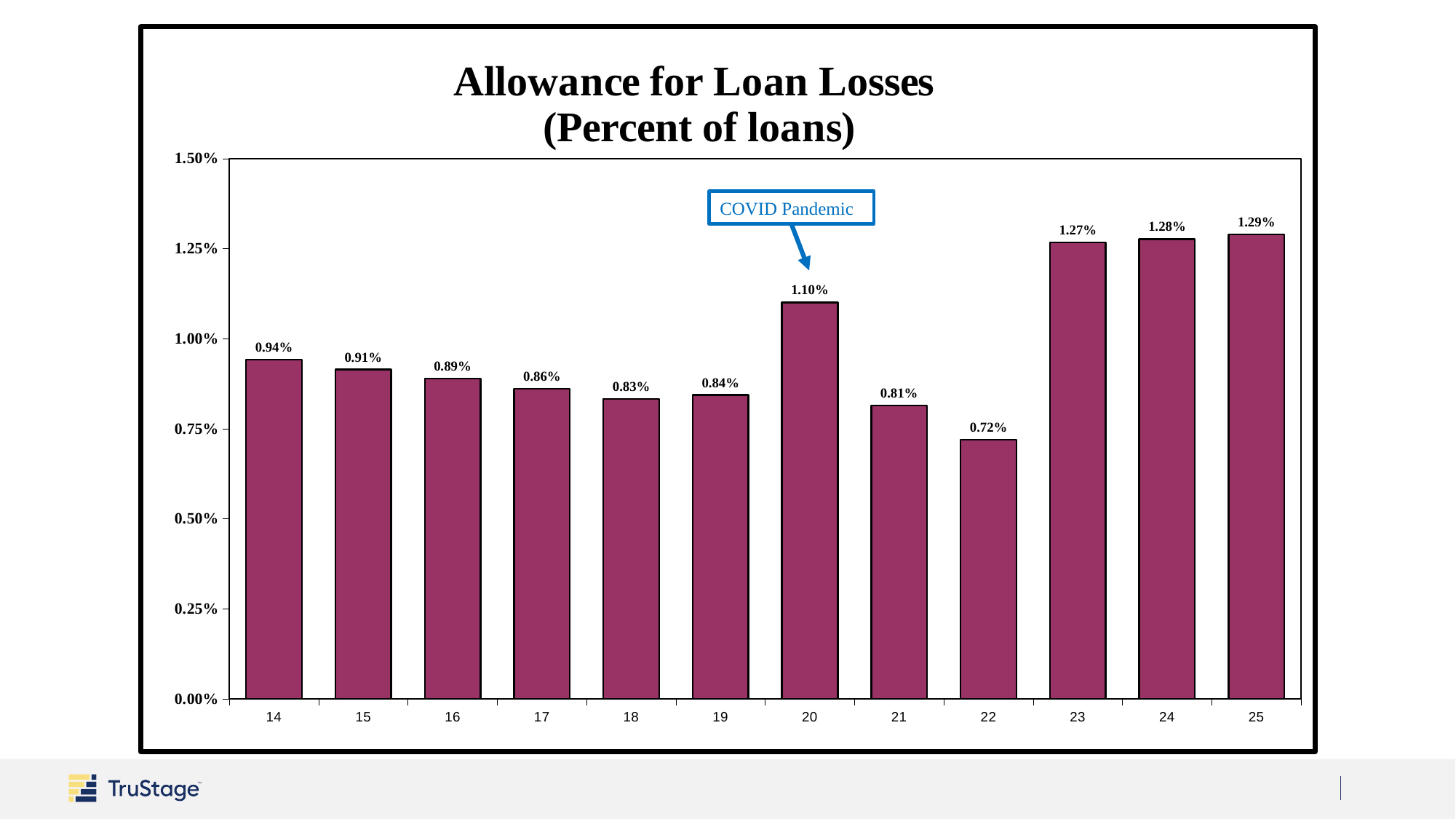
Which year has the highest allowance for loan losses? 25 Do the values rise or fall from year 14 to year 18? Fall What is the allowance for loan losses in year 14? 0.94% How many years are shown on the chart? 12 What is the allowance for loan losses in year 20? 1.10% What is the difference between the allowance for loan losses in year 20 and year 19? 0.26% Which year does the 'COVID Pandemic' annotation point to? 20 Which year has a larger allowance for loan losses, 16 or 21? 16 Is the value for year 23 greater or less than 1.00%? greater What is the allowance for loan losses in year 22? 0.72% What kind of chart is shown on the slide? Bar chart Which year has the lowest allowance for loan losses? 22